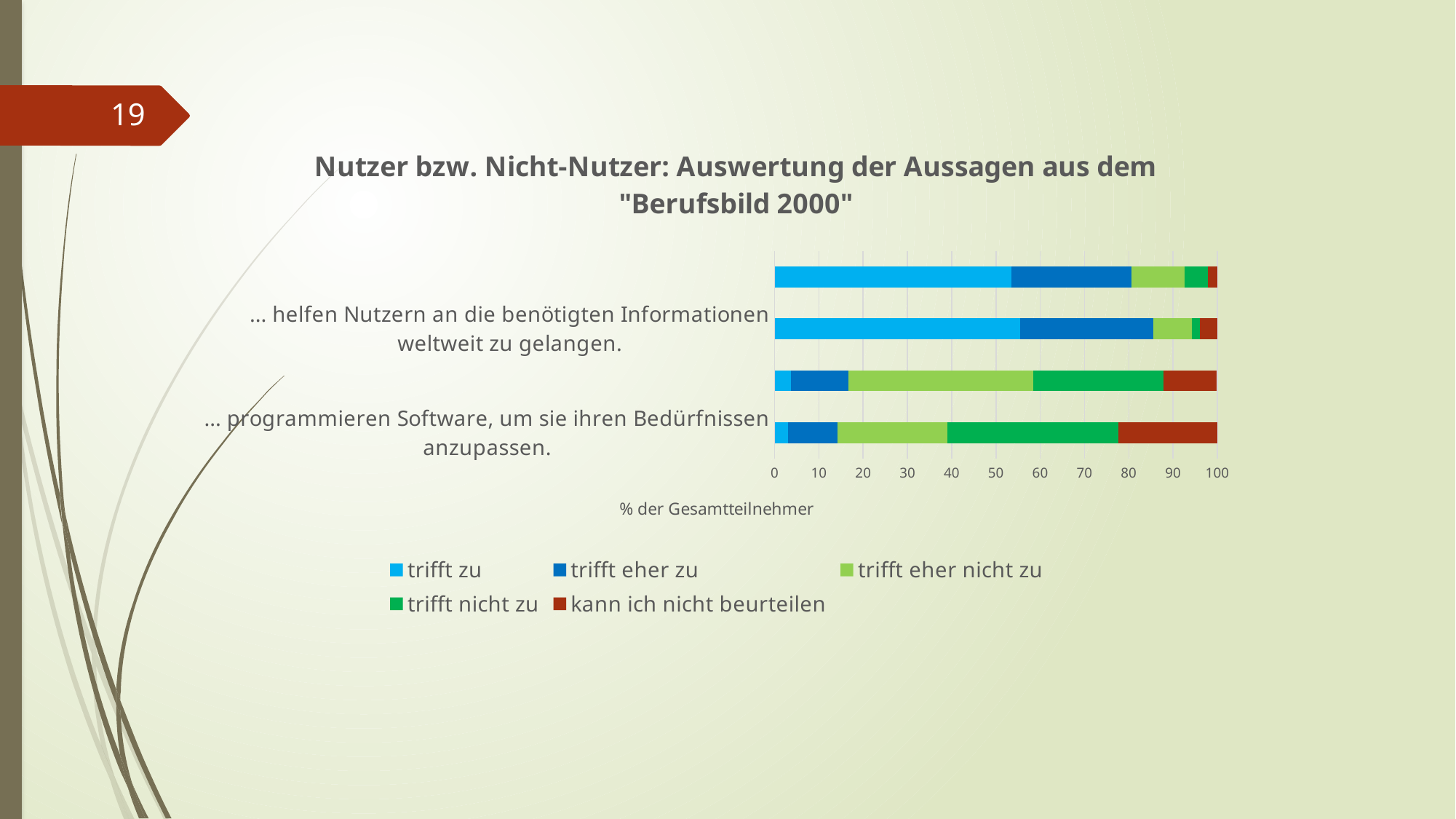
In the bottom bar, is the 'trifft zu' segment greater or less than 10? less Which bar has the larger 'trifft zu' segment, the top bar or the third bar from the top? the top bar What kind of chart is shown on the slide? bar chart In the bottom bar, is the 'kann ich nicht beurteilen' segment greater or less than 10? greater What is the label of the horizontal axis? % der Gesamtteilnehmer Which of the four bars has the largest 'trifft nicht zu' segment? the bottom bar Which bar has the larger 'kann ich nicht beurteilen' segment, the bottom bar or the third bar from the top? the bottom bar How many series does the legend list? 5 In the top bar, is the 'trifft zu' segment greater or less than 40? greater How many stacked bars are plotted in the chart? 4 What is the title of the chart? Nutzer bzw. Nicht-Nutzer: Auswertung der Aussagen aus dem "Berufsbild 2000"